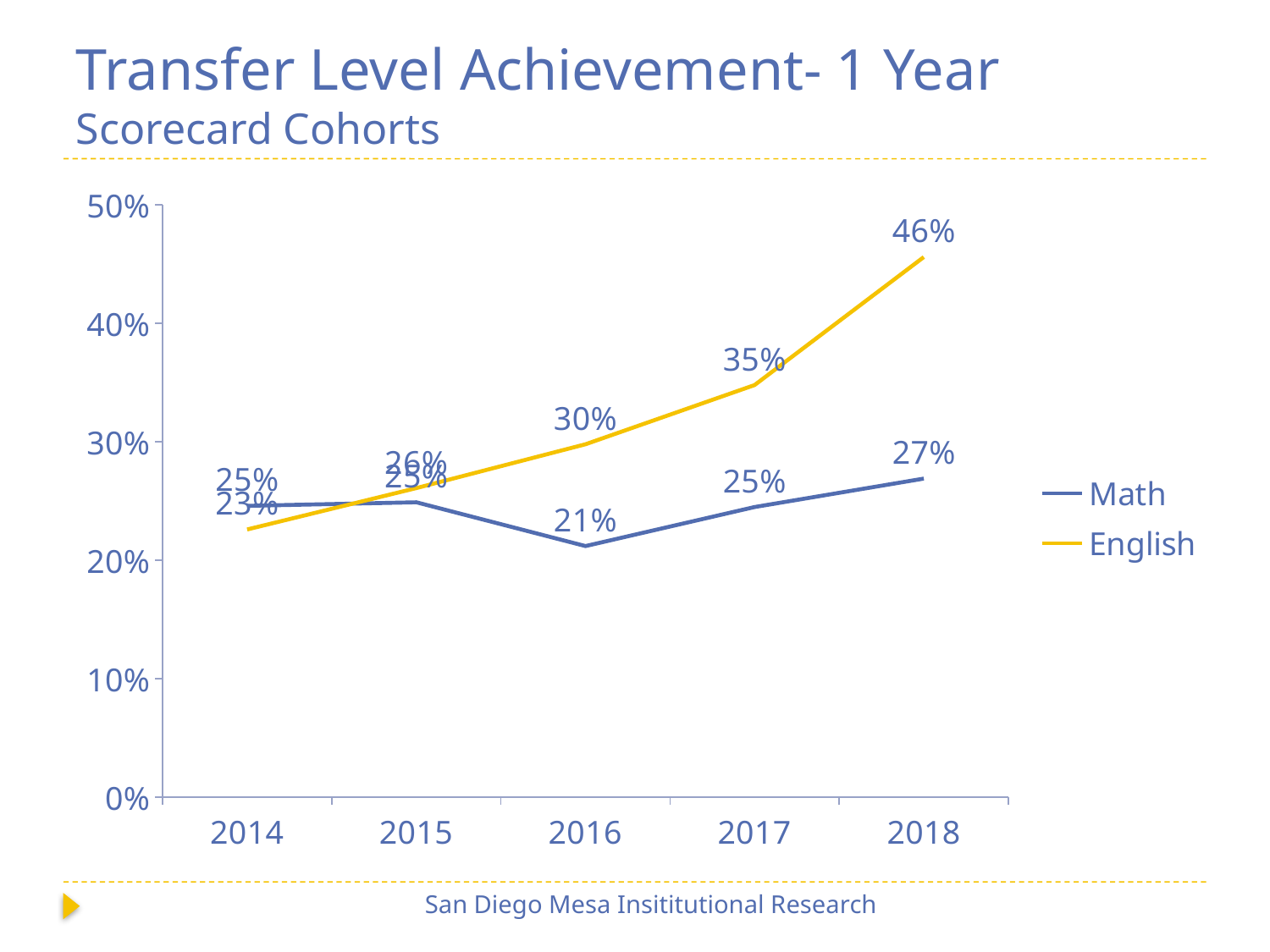
How many years are shown on the x axis? 5 What is the Math value for 2016? 21% What is the English value for 2016? 30% How many series does the legend list? 2 What is the Math value for 2018? 27% What is the English value for 2017? 35% What kind of chart is shown on the slide? Line chart In 2017, which series has the higher value, Math or English? English In which year is the Math value lowest? 2016 What is the difference between the English and Math values in 2018? 19 percentage points What is the English value for 2018? 46% In which year is the English value highest? 2018